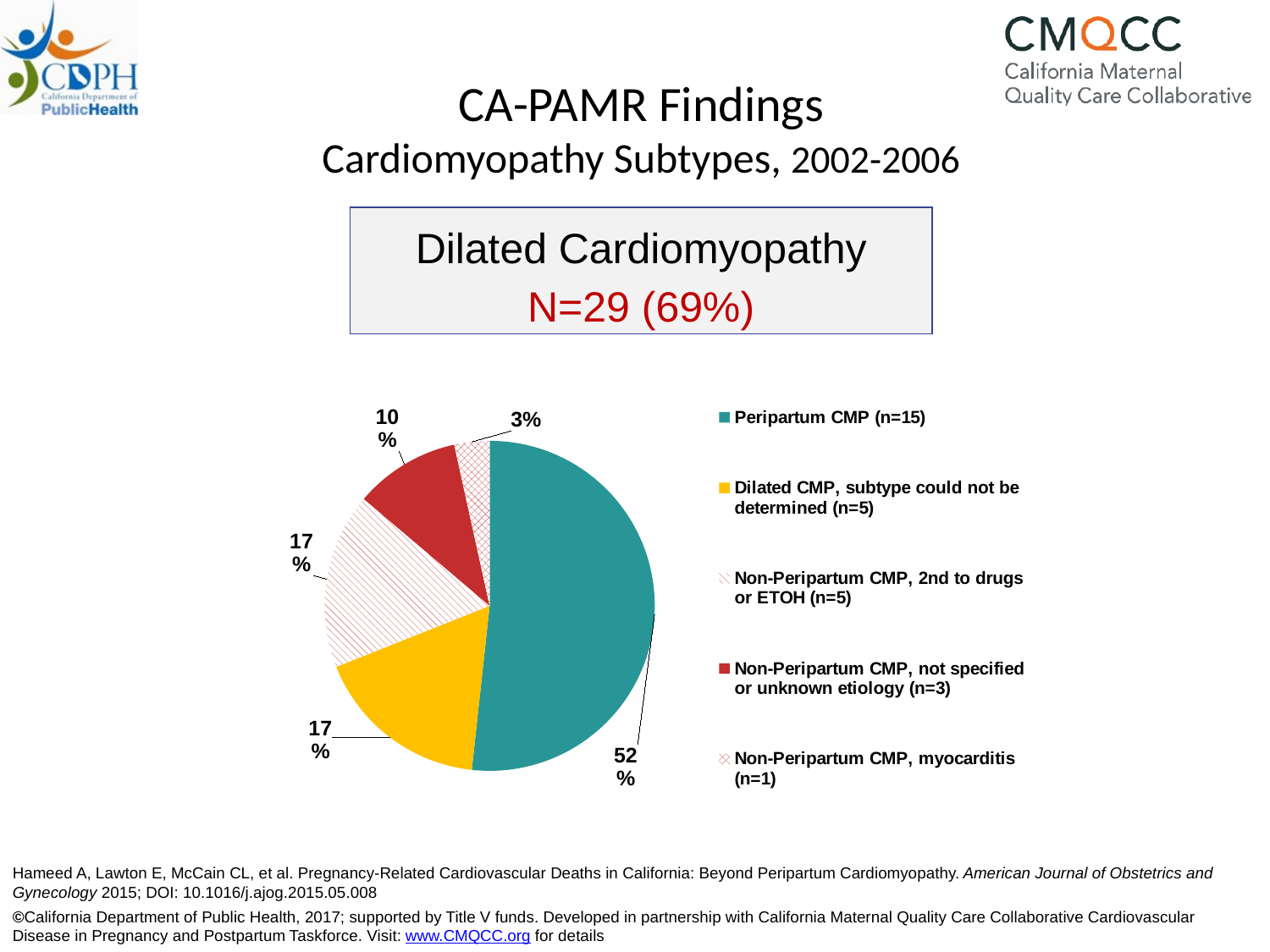
How many entries does the legend of the pie chart list? 5 According to the legend, how many cases are in the Dilated CMP, subtype could not be determined category? n=5 Which category has the largest share of the pie chart? Peripartum CMP (n=15) Which slice is larger: Peripartum CMP or Dilated CMP, subtype could not be determined? Peripartum CMP How many slices does the pie chart have? 5 What percentage of the pie is Non-Peripartum CMP, myocarditis? 3% Which category has the smallest share of the pie chart? Non-Peripartum CMP, myocarditis (n=1) What kind of chart is shown on the slide? pie chart What percentage of the pie is Peripartum CMP? 52% What is the difference in percentage points between the Peripartum CMP slice and the Non-Peripartum CMP, not specified or unknown etiology slice? 42 What is the total N shown in the box above the pie chart for Dilated Cardiomyopathy? N=29 (69%) What percentage of the pie is Non-Peripartum CMP, not specified or unknown etiology? 10%